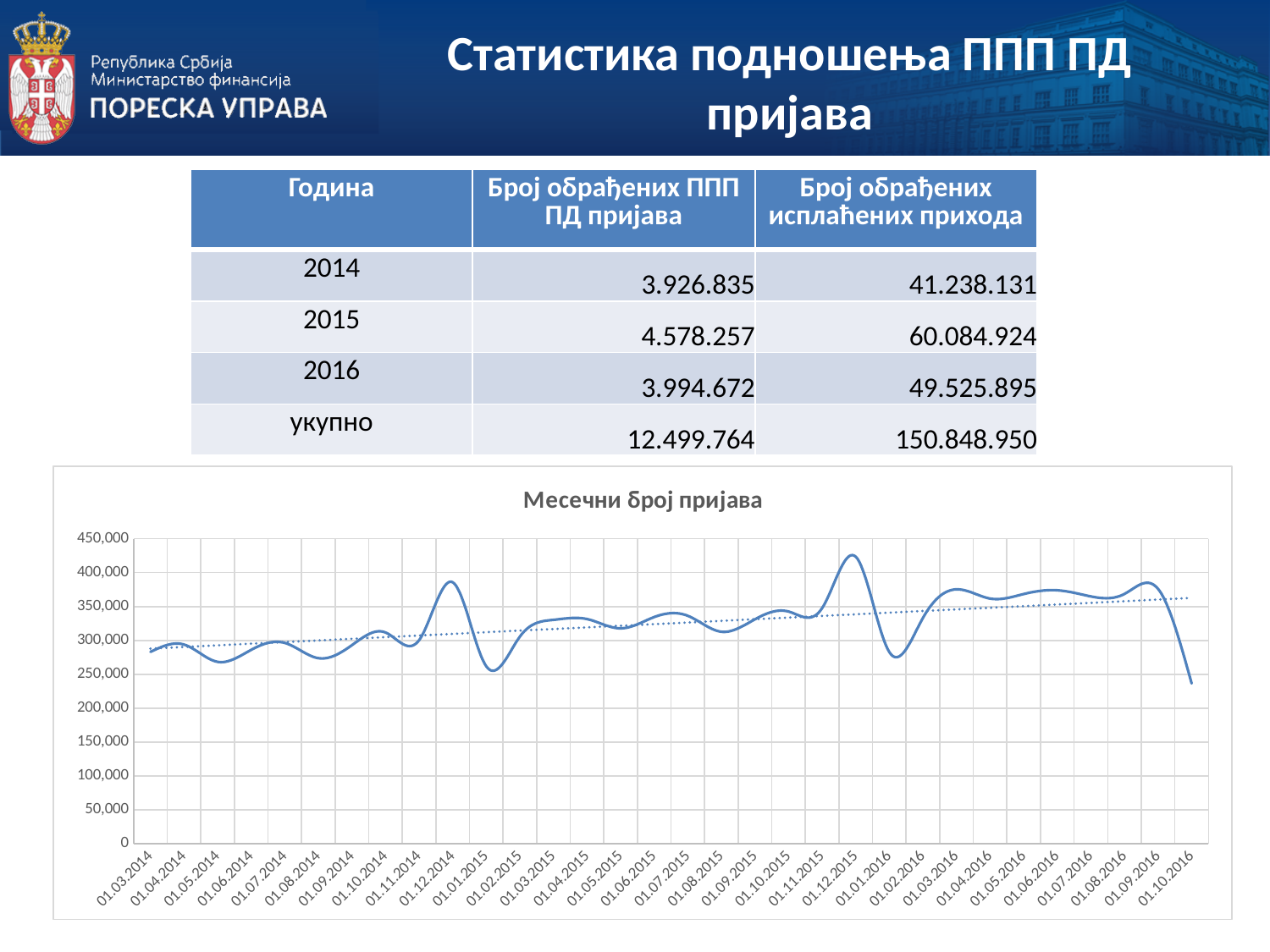
What is the title of the chart on the slide? Месечни број пријава What is the highest value shown on the y axis of the chart? 450,000 Which is larger, the value for 01.12.2014 or the value for 01.12.2015? 01.12.2015 Is the value for 01.01.2015 greater or less than 300,000? less Is the value for 01.12.2014 greater or less than 350,000? greater How many monthly points are plotted along the x axis of the chart? 32 Does the dotted trend line on the chart rise or fall from left to right? rise Is the value for 01.03.2016 greater or less than 350,000? greater Which month has the highest value on the chart? 01.12.2015 What kind of chart is shown under the table on the slide? line chart